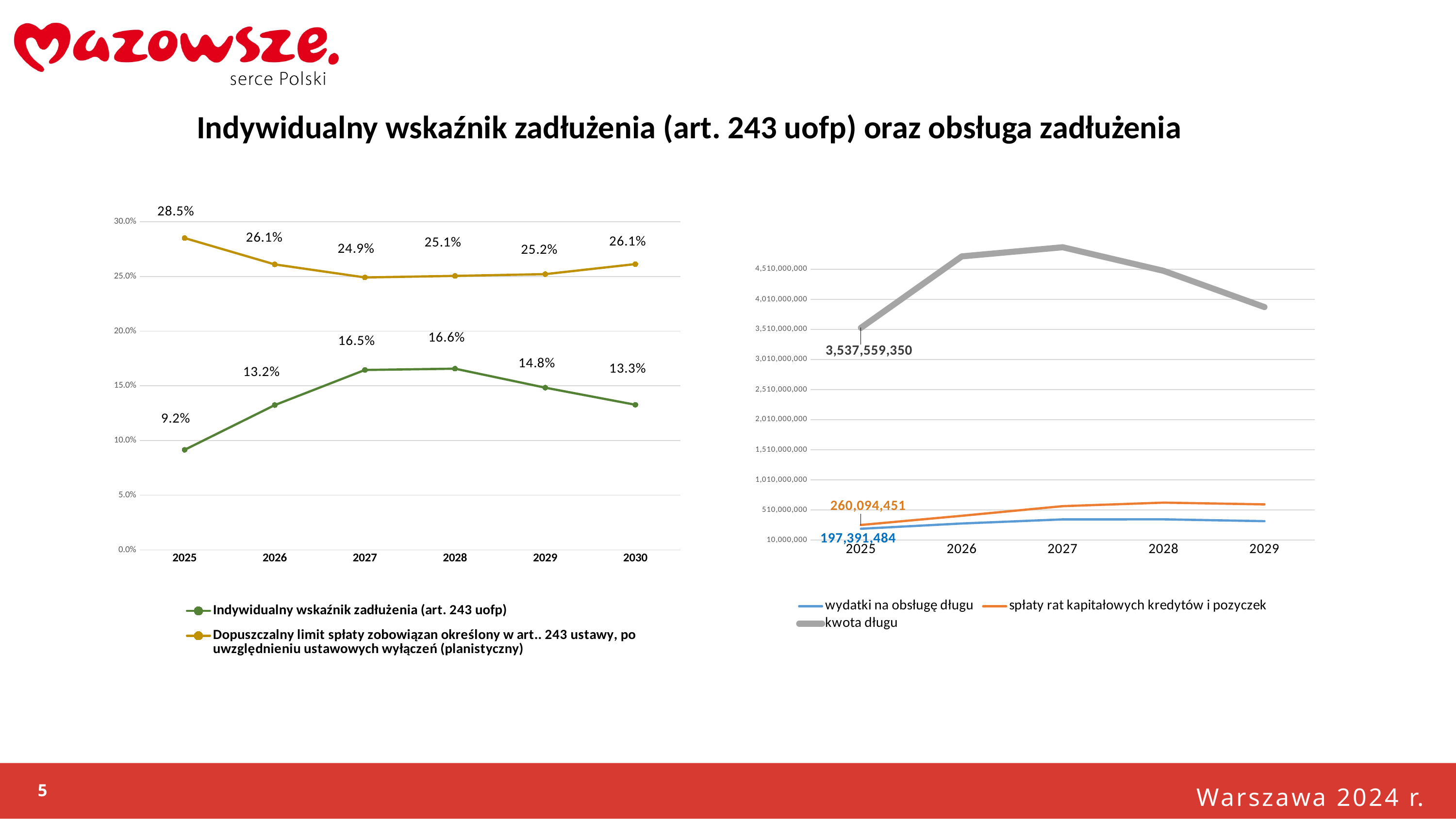
In the left chart, what is the difference between the Dopuszczalny limit and the Indywidualny wskaźnik zadłużenia in 2025? 19.3% In the right chart, what is the value of kwota długu for 2025? 3,537,559,350 In the left chart, in which year is Indywidualny wskaźnik zadłużenia (art. 243 uofp) highest? 2028 In the right chart, is the value of kwota długu for 2027 greater or less than 4,510,000,000? greater In the left chart, is the Indywidualny wskaźnik zadłużenia higher in 2027 or in 2030? 2027 In the right chart, how many series does the legend list? 3 In the left chart, in which year is the Dopuszczalny limit spłaty zobowiązań series lowest? 2027 In the left chart, what is the value of the Dopuszczalny limit spłaty zobowiązań series for 2027? 24.9% What type of chart is the right chart? Line chart In the right chart, what is the value of wydatki na obsługę długu for 2025? 197,391,484 In the left chart, what is the value of Indywidualny wskaźnik zadłużenia (art. 243 uofp) for 2025? 9.2% In the left chart, how many years are shown on the x axis? 6